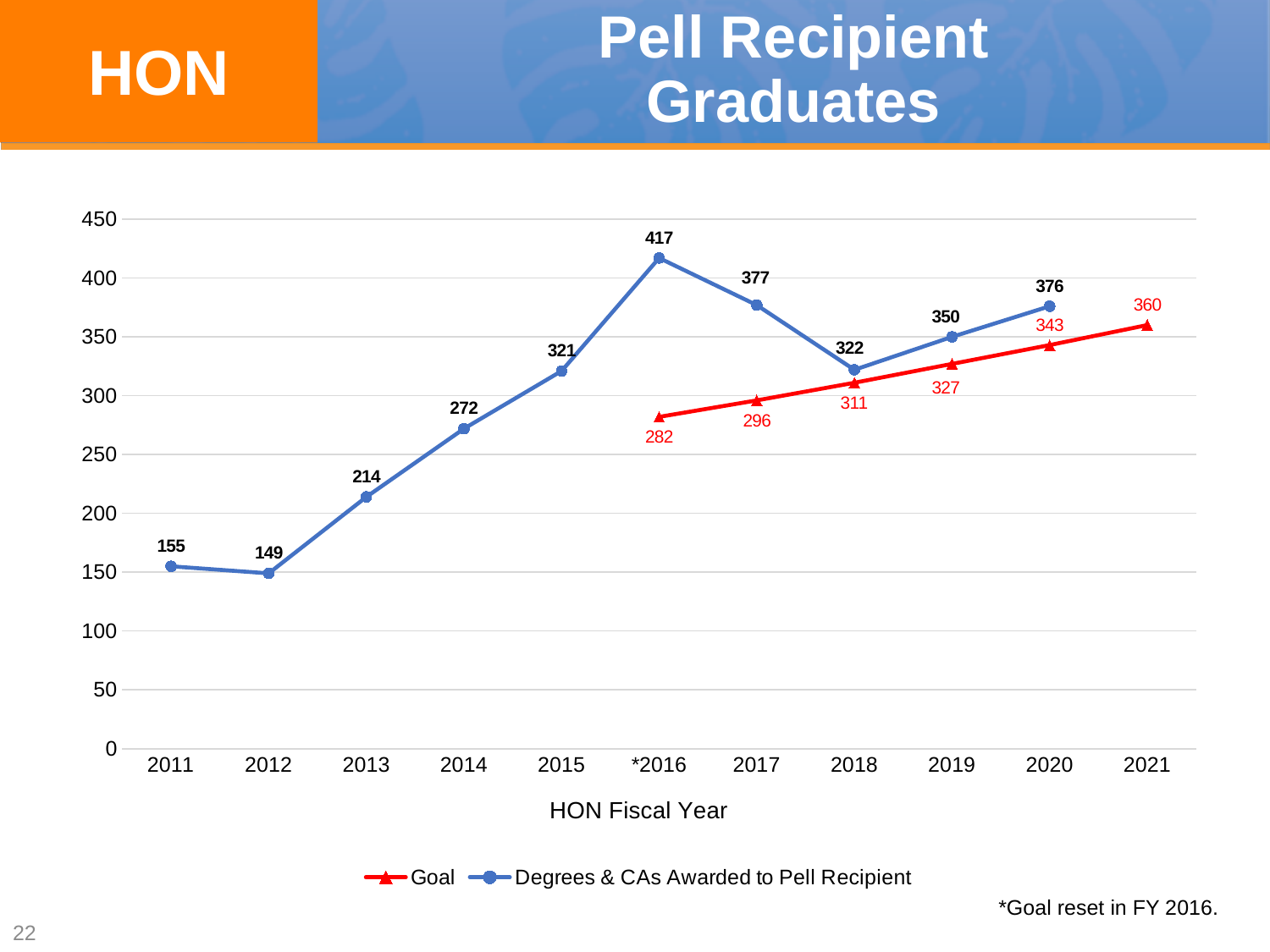
Does the Goal series rise or fall from *2016 to 2021? Rise What colour is the Goal line? Red Which is larger in 2018: the Goal or the Degrees & CAs Awarded to Pell Recipient value? Degrees & CAs Awarded to Pell Recipient In which year is the Degrees & CAs Awarded to Pell Recipient value lowest? 2012 What kind of chart is shown on the slide? Line chart How many years are shown on the x axis? 11 What is the Goal value for 2019? 327 What is the x-axis title of the chart? HON Fiscal Year In which year is the Degrees & CAs Awarded to Pell Recipient value highest? *2016 What is the difference between the Degrees & CAs Awarded to Pell Recipient value and the Goal value in 2020? 33 What is the value for Degrees & CAs Awarded to Pell Recipient in 2014? 272 How many series does the legend list? 2